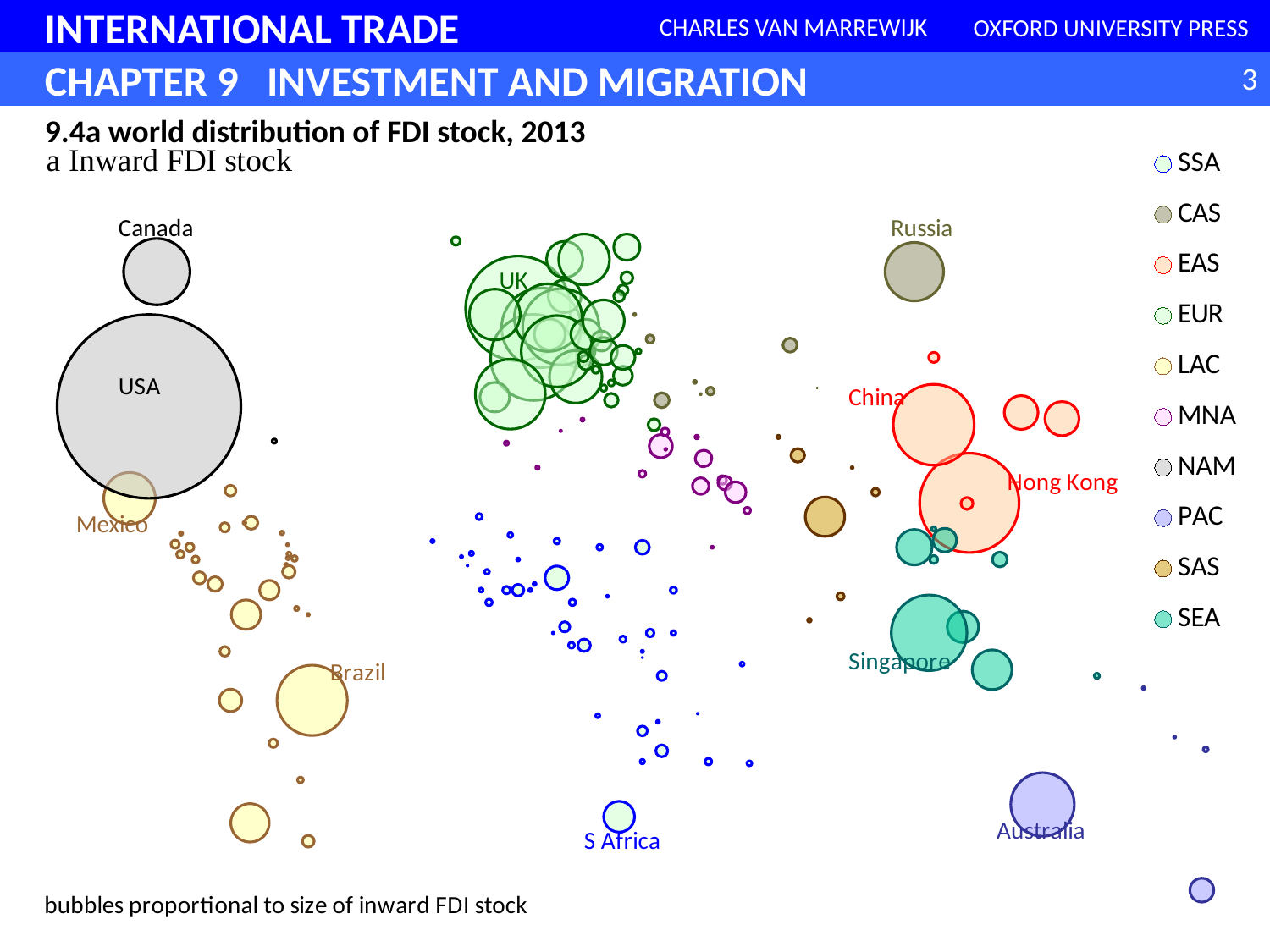
Which has the larger bubble, UK or Canada? UK How many regions does the legend list? 10 Which has the larger bubble, Brazil or Mexico? Brazil Which has the larger bubble, Australia or S Africa? Australia What colour are the bubbles for the EUR region in the legend? green Which labelled country has the largest bubble for inward FDI stock? USA What kind of chart is shown on the slide? bubble chart What is the title of the chart? 9.4a world distribution of FDI stock, 2013